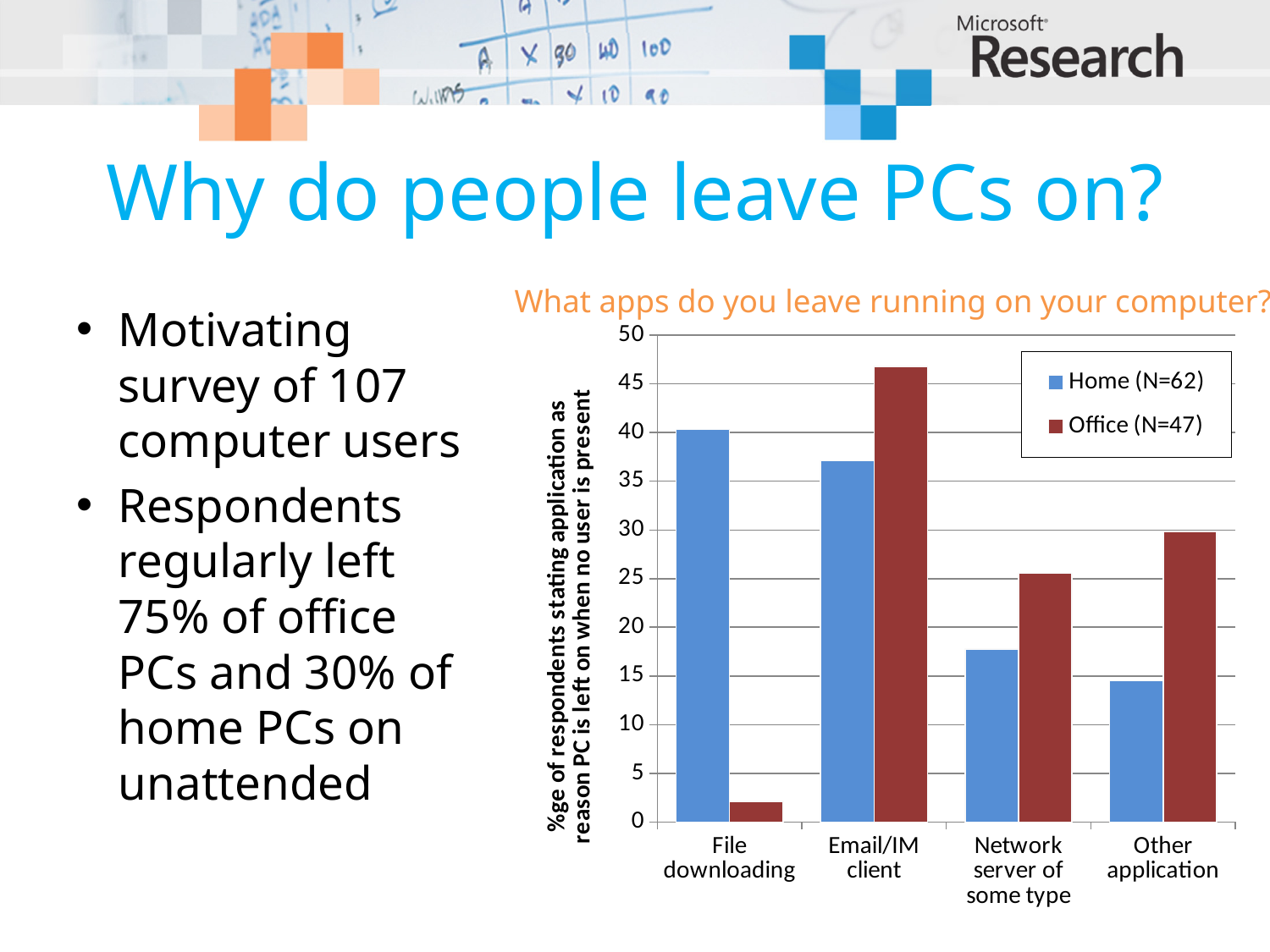
How many series does the chart legend list? 2 Which series in the chart is shown in blue? Home (N=62) How many application categories are shown on the x axis of the chart? 4 For the Home (N=62) series, which category has the highest value? File downloading For the Home (N=62) series, which category has the lowest value? Other application What is the title of the chart? What apps do you leave running on your computer? Is the Office (N=47) value for File downloading greater or less than 5? less What kind of chart is shown on the slide? bar chart For Network server of some type, which is larger: the Home (N=62) value or the Office (N=47) value? Office (N=47) For the Office (N=47) series, which category has the lowest value? File downloading For the Office (N=47) series, which category has the highest value? Email/IM client